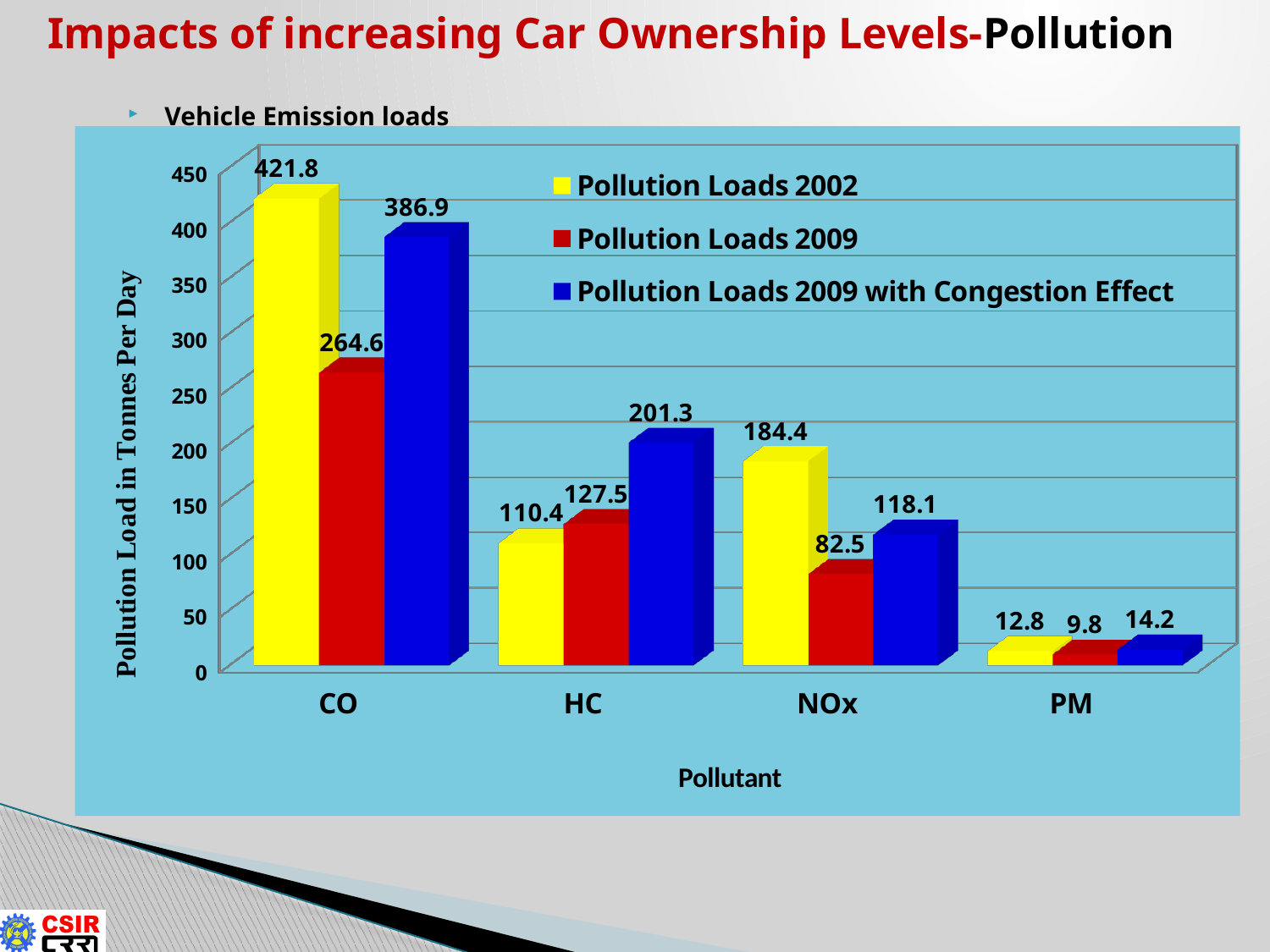
What is the y-axis title of the chart? Pollution Load in Tonnes Per Day What is the Pollution Loads 2002 value for CO? 421.8 Which pollutant has the lowest Pollution Loads 2009 with Congestion Effect value? PM How many pollutant categories are shown on the x axis? 4 Which colour represents Pollution Loads 2009 with Congestion Effect in the legend? Blue Which is larger for HC: Pollution Loads 2002 or Pollution Loads 2009? Pollution Loads 2009 How many series does the legend list? 3 Which pollutant has the highest Pollution Loads 2002 value? CO What kind of chart is shown on the slide? Bar chart What is the Pollution Loads 2009 value for NOx? 82.5 What is the Pollution Loads 2009 with Congestion Effect value for HC? 201.3 What is the difference between the Pollution Loads 2002 and Pollution Loads 2009 values for CO? 157.2